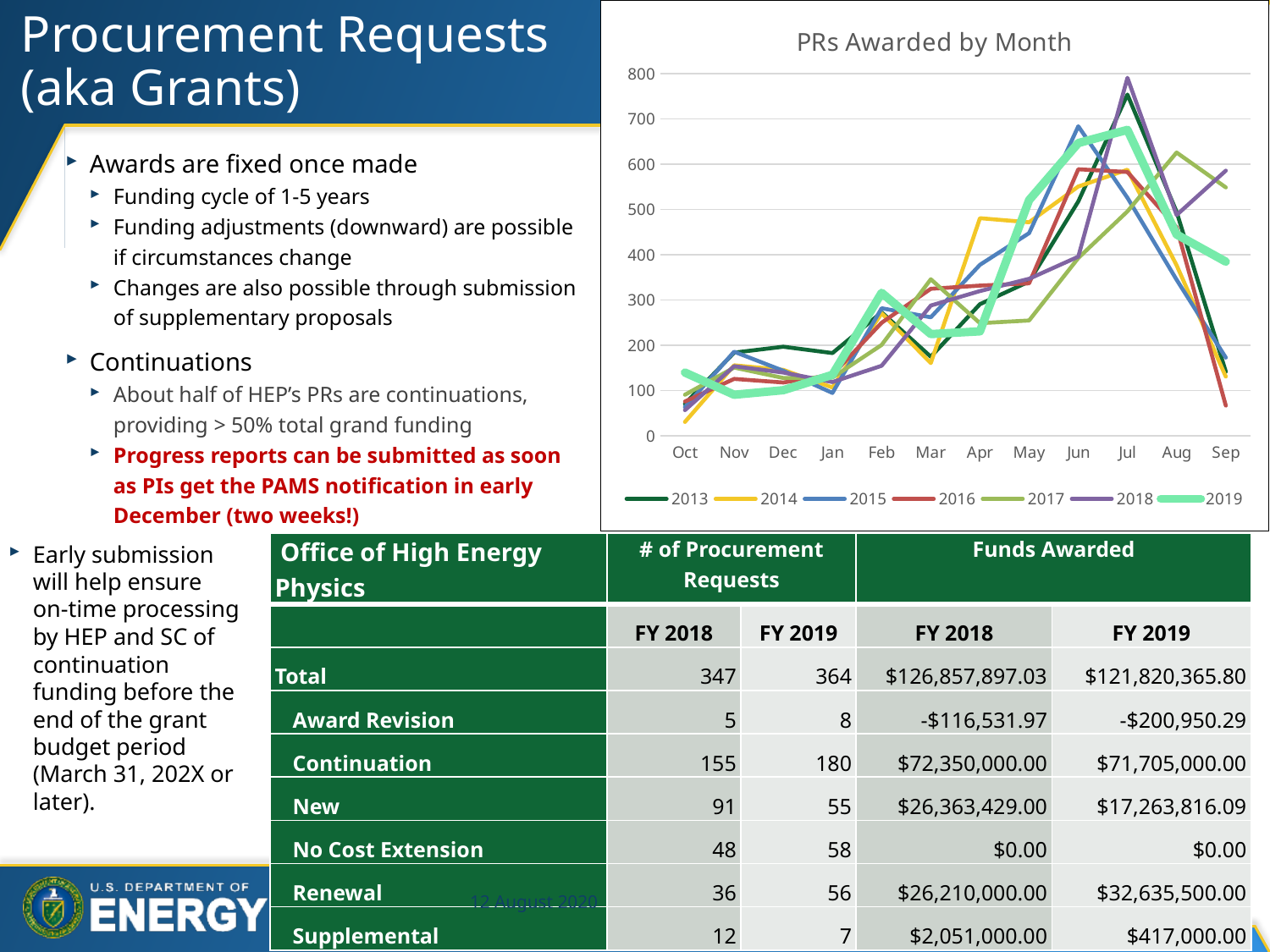
In the 'PRs Awarded by Month' chart, which is larger in Sep: the value for 2018 or the value for 2016? 2018 In the 'PRs Awarded by Month' chart, is the value for 2014 in Oct greater or less than 100? less How many months are shown on the x axis of the 'PRs Awarded by Month' chart? 12 In the 'PRs Awarded by Month' chart, is the value for 2018 in Jul greater or less than 700? greater What is the title of the line chart on the slide? PRs Awarded by Month In the 'PRs Awarded by Month' chart, which month has the highest value for the 2018 series? Jul In the 'PRs Awarded by Month' chart, is the value for 2016 in Sep greater or less than 100? less In the 'PRs Awarded by Month' chart, which month has the highest value for the 2017 series? Aug In the 'PRs Awarded by Month' chart, do the values for 2018 rise or fall from Jan to Jul? rise What kind of chart is 'PRs Awarded by Month'? line chart How many series does the legend of the 'PRs Awarded by Month' chart list? 7